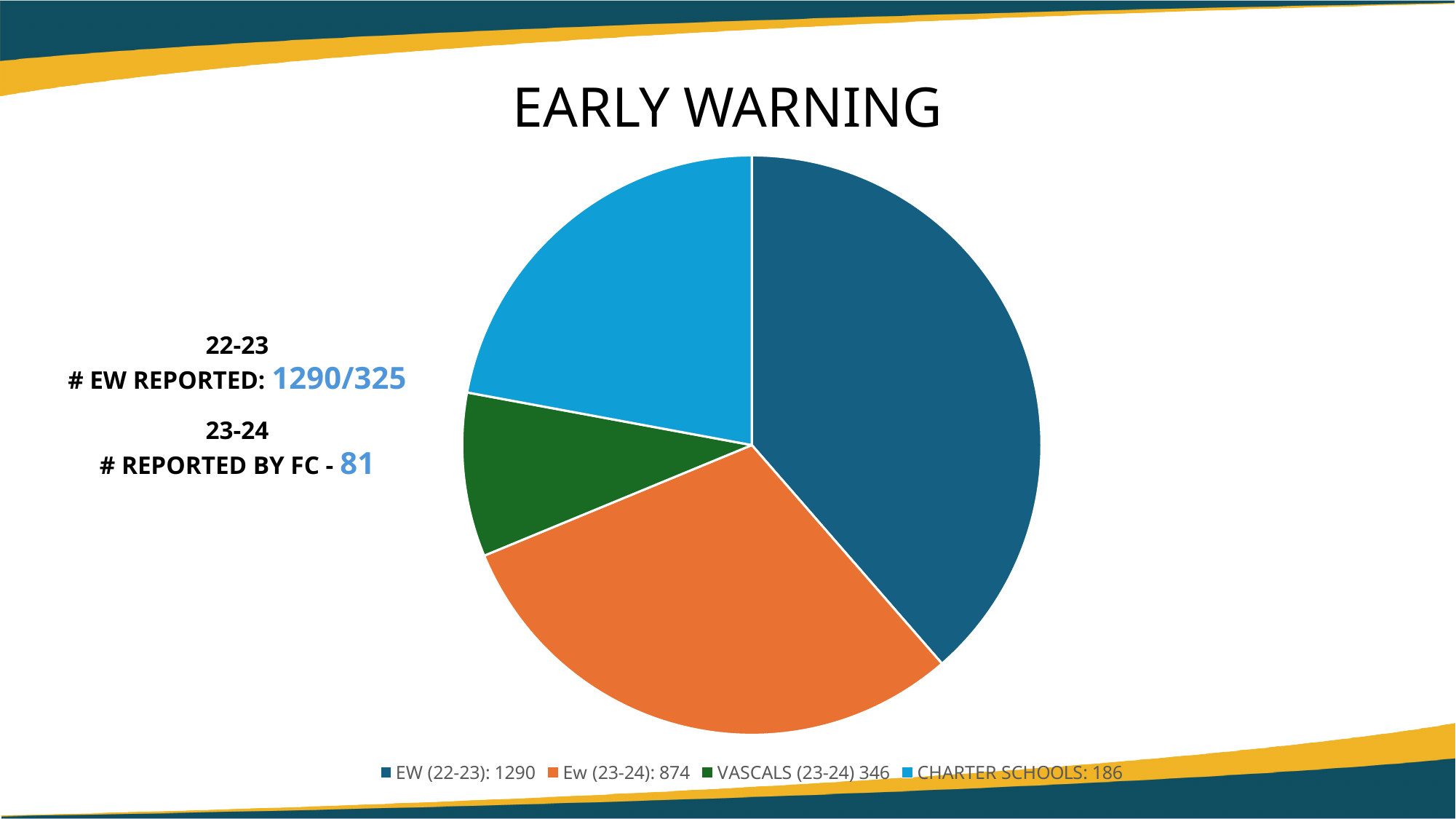
What colour is the EW (22-23) slice? dark blue What is the difference between the EW (22-23) value and the Ew (23-24) value shown in the legend? 416 What is the title of the chart? EARLY WARNING How many slices does the pie chart have? 4 What value is shown in the legend for EW (22-23)? 1290 What value is shown in the legend for VASCALS (23-24)? 346 How many entries does the legend list? 4 What kind of chart is shown on the slide? pie chart What value is shown in the legend for CHARTER SCHOOLS? 186 Which category has the largest slice of the pie? EW (22-23) Which is larger, EW (22-23) or Ew (23-24)? EW (22-23) What value is shown in the legend for Ew (23-24)? 874